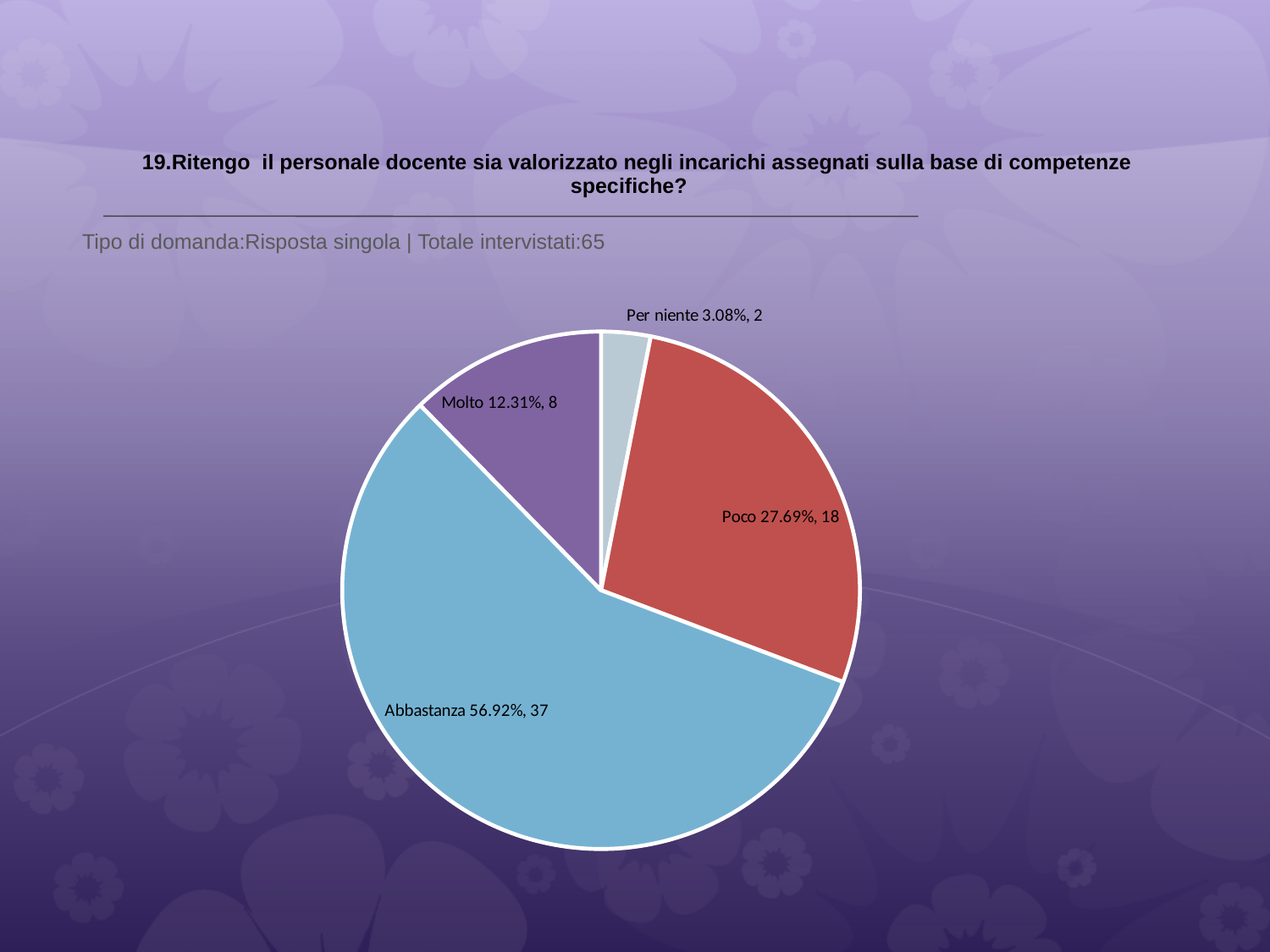
What percentage share does the 'Molto' slice represent? 12.31% How many slices does the pie chart have? 4 Which response category has the largest slice? Abbastanza What percentage share does the 'Abbastanza' slice represent? 56.92% What kind of chart is shown on the slide? pie chart What is the difference in number of respondents between 'Abbastanza' and 'Poco'? 19 What colour is the 'Poco' slice? red How many respondents answered 'Per niente'? 2 How many respondents answered 'Poco'? 18 Which has more respondents, 'Molto' or 'Poco'? Poco What is the total number of respondents shown in the subtitle? 65 Which response category has the smallest slice? Per niente